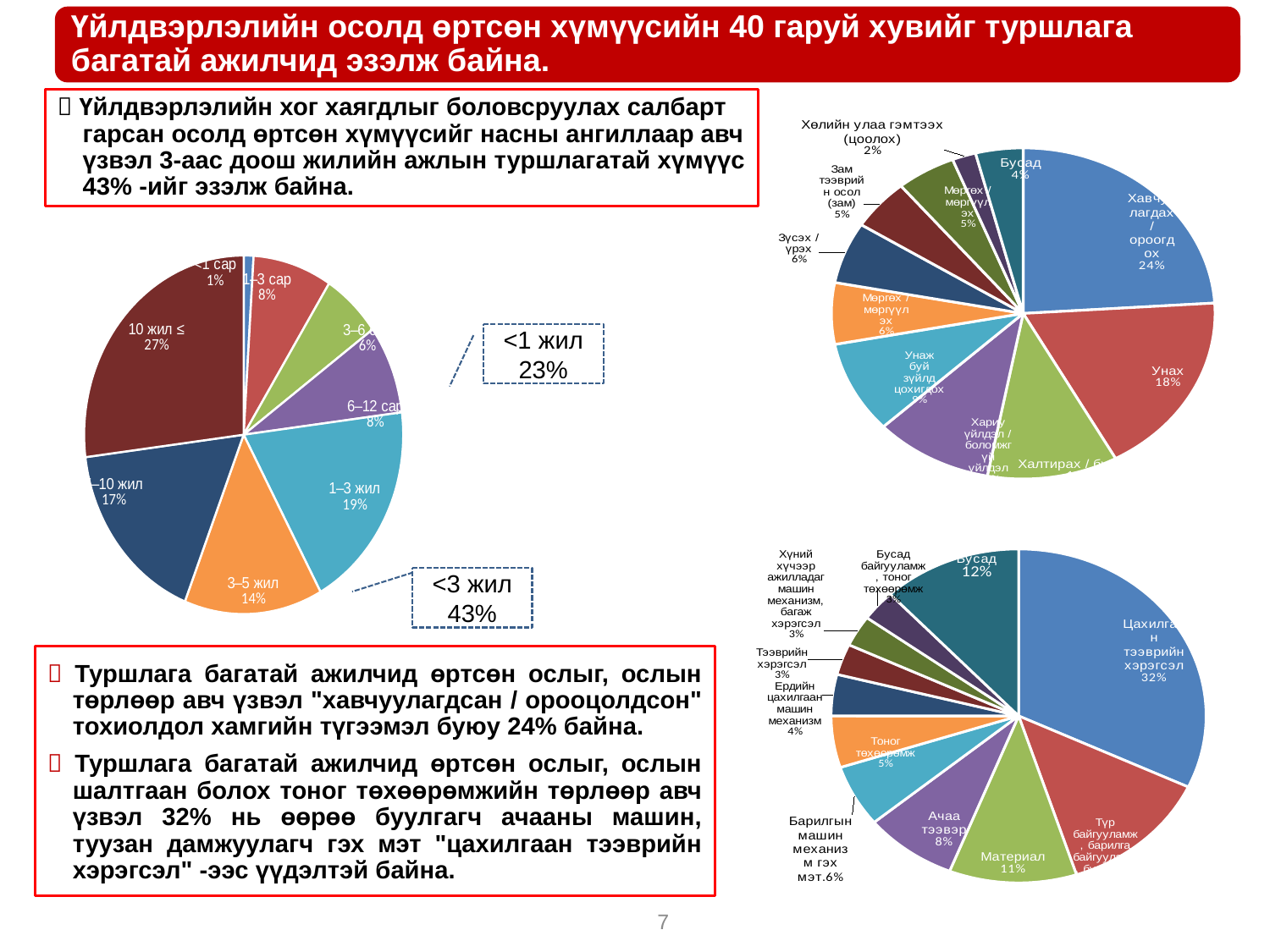
On the top-right pie chart, what share is shown for "Хавчуулагдах / орооцолдох"? 24% What type of chart is used for the three charts on the slide? Pie chart On the pie chart on the left of the slide, what is the difference in percentage points between "3–5 жил" and "5–10 жил"? 3 On the top-right pie chart, what share is shown for "Хөлийн улаа гэмтээх (цоолох)"? 2% On the bottom-right pie chart, what share is shown for "Цахилгаан тээврийн хэрэгсэл"? 32% On the pie chart on the left of the slide, which category has the largest share? 10 жил ≤ On the top-right pie chart, what share is shown for "Унах"? 18% On the pie chart on the left of the slide, which is larger: the share for "1–3 жил" or the share for "3–5 жил"? 1–3 жил On the pie chart on the left of the slide, what share is shown for the "10 жил ≤" category? 27% On the pie chart on the left of the slide, what share is shown for "1–3 жил"? 19% On the bottom-right pie chart, what share is shown for "Материал"? 11% On the pie chart on the left of the slide, which category has the smallest share? <1 сар